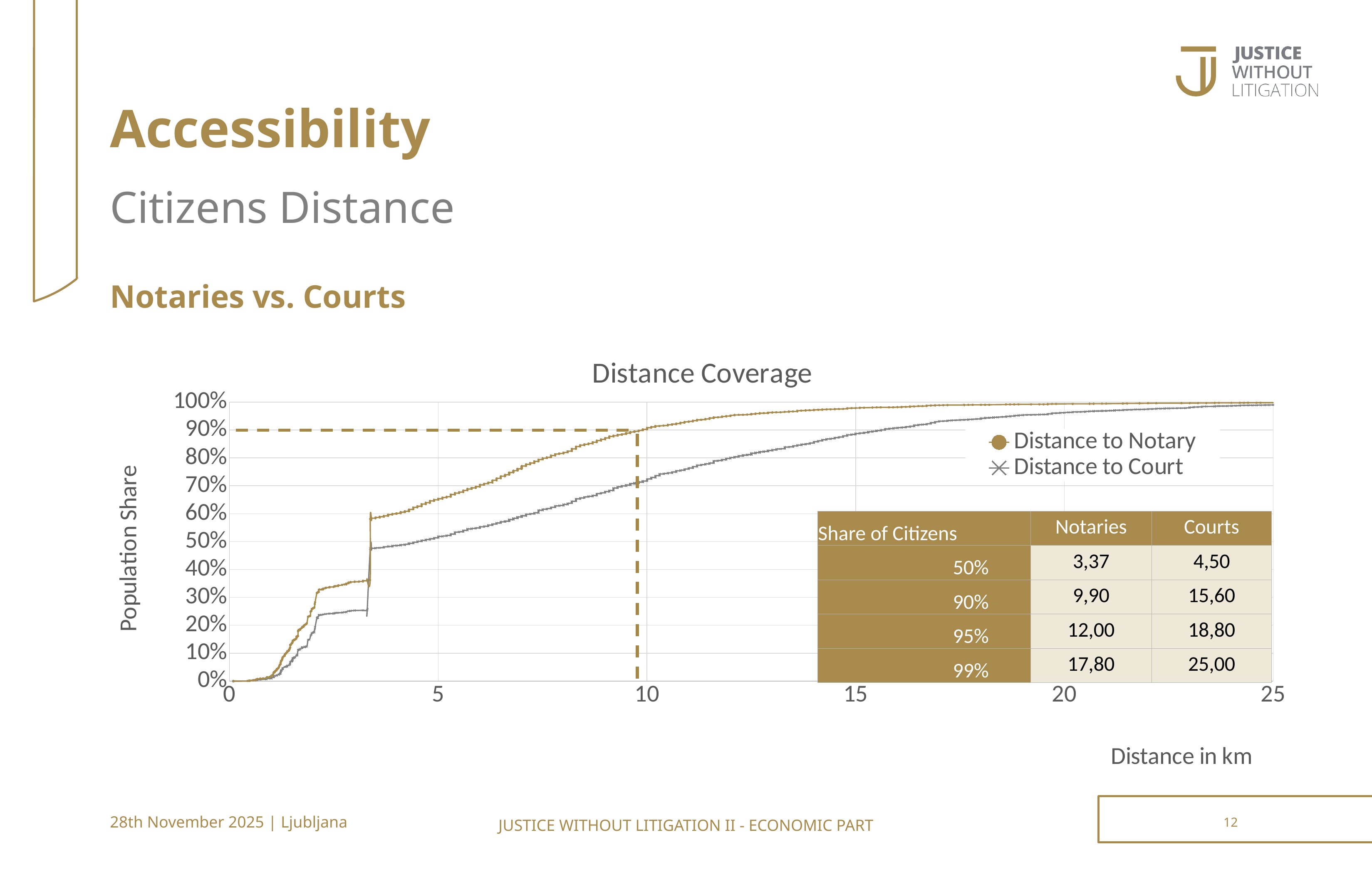
How many series does the legend of the Distance Coverage chart list? 2 According to the table on the Distance Coverage chart, what is the difference between the Courts and Notaries distances at a 90% share of citizens? 5,70 According to the table on the Distance Coverage chart, what is the distance in km for Notaries at a 90% share of citizens? 9,90 In the Distance Coverage chart, is the population share for Distance to Notary at 15 km greater or less than 90%? greater What kind of chart is the Distance Coverage chart? line chart In the Distance Coverage chart, at 10 km, which series has the higher population share, Distance to Notary or Distance to Court? Distance to Notary According to the table on the Distance Coverage chart, what is the distance in km for Courts at a 99% share of citizens? 25,00 In the Distance Coverage chart, is the population share for Distance to Court at 10 km greater or less than 80%? less In the Distance Coverage chart, is the population share for Distance to Court at 20 km greater or less than 90%? greater What are the two series named in the legend of the Distance Coverage chart? Distance to Notary and Distance to Court What is the label of the vertical axis of the Distance Coverage chart? Population Share In the Distance Coverage chart, do the lines rise or fall as distance increases? rise